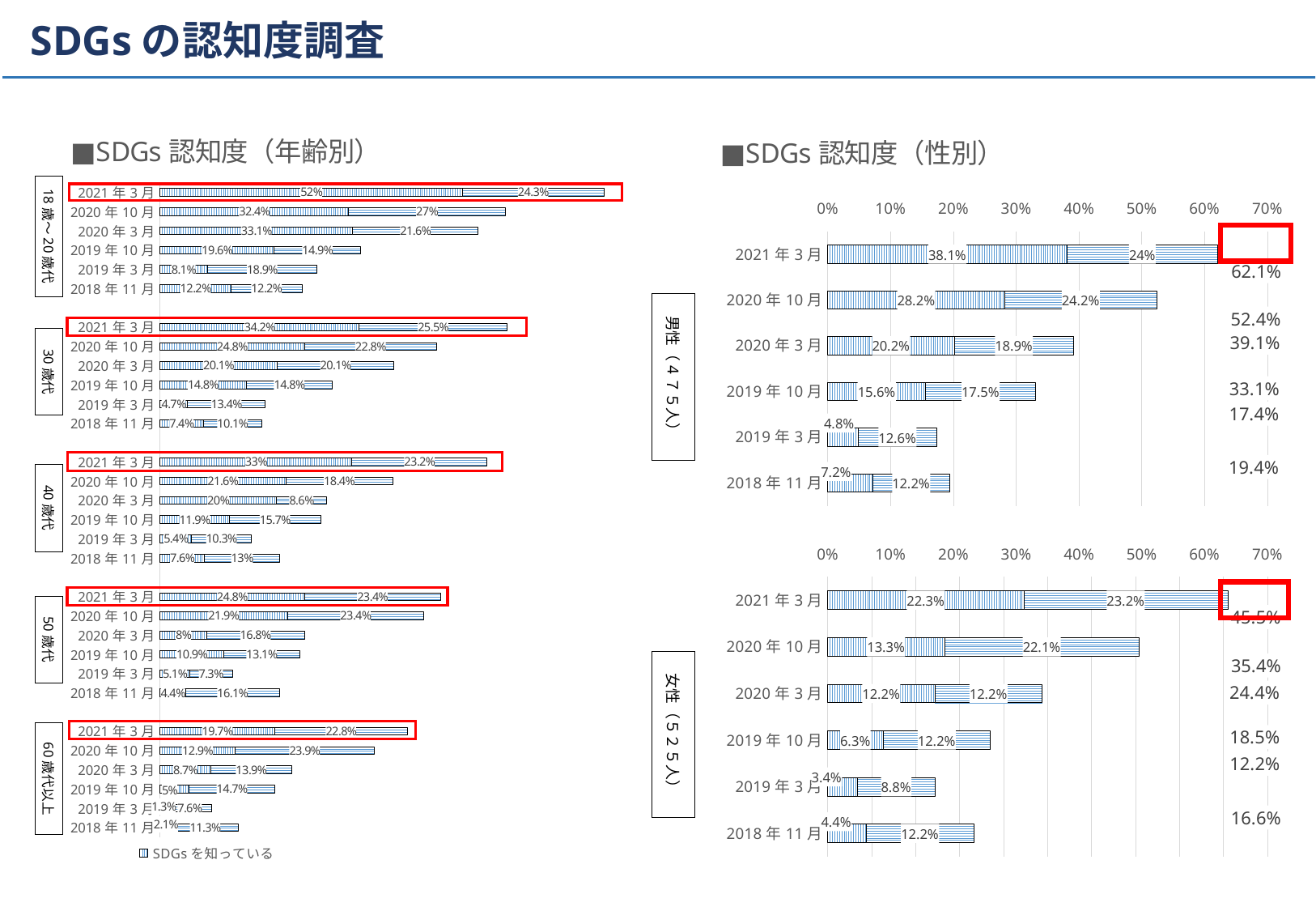
What kind of chart is the SDGs 認知度（性別） chart? bar chart In the SDGs 認知度（年齢別） chart, what is the first data label for 60歳代以上 in 2021年3月? 19.7% In the SDGs 認知度（性別） chart, how many respondents are indicated for 女性? 525人 In the SDGs 認知度（性別） chart, what is the first data label for 男性 in 2021年3月? 38.1% In the SDGs 認知度（性別） chart, which survey period has the highest total for 女性? 2021年3月 In the SDGs 認知度（性別） chart, what total is shown for 男性 in 2021年3月? 62.1% In the SDGs 認知度（性別） chart, what is the difference between the 男性 total for 2021年3月 (62.1%) and the 女性 total for 2021年3月 (45.5%)? 16.6% How many survey periods are shown for each age group in the SDGs 認知度（年齢別） chart? 6 In the SDGs 認知度（年齢別） chart, what is the first data label for 18歳～20歳代 in 2021年3月? 52% In the SDGs 認知度（性別） chart, what total is shown for 女性 in 2021年3月? 45.5% In the SDGs 認知度（性別） chart, which is larger for 男性 in 2020年10月: the first segment (28.2%) or the second segment (24.2%)? 28.2% In the SDGs 認知度（性別） chart, which survey period has the lowest total for 男性? 2019年3月